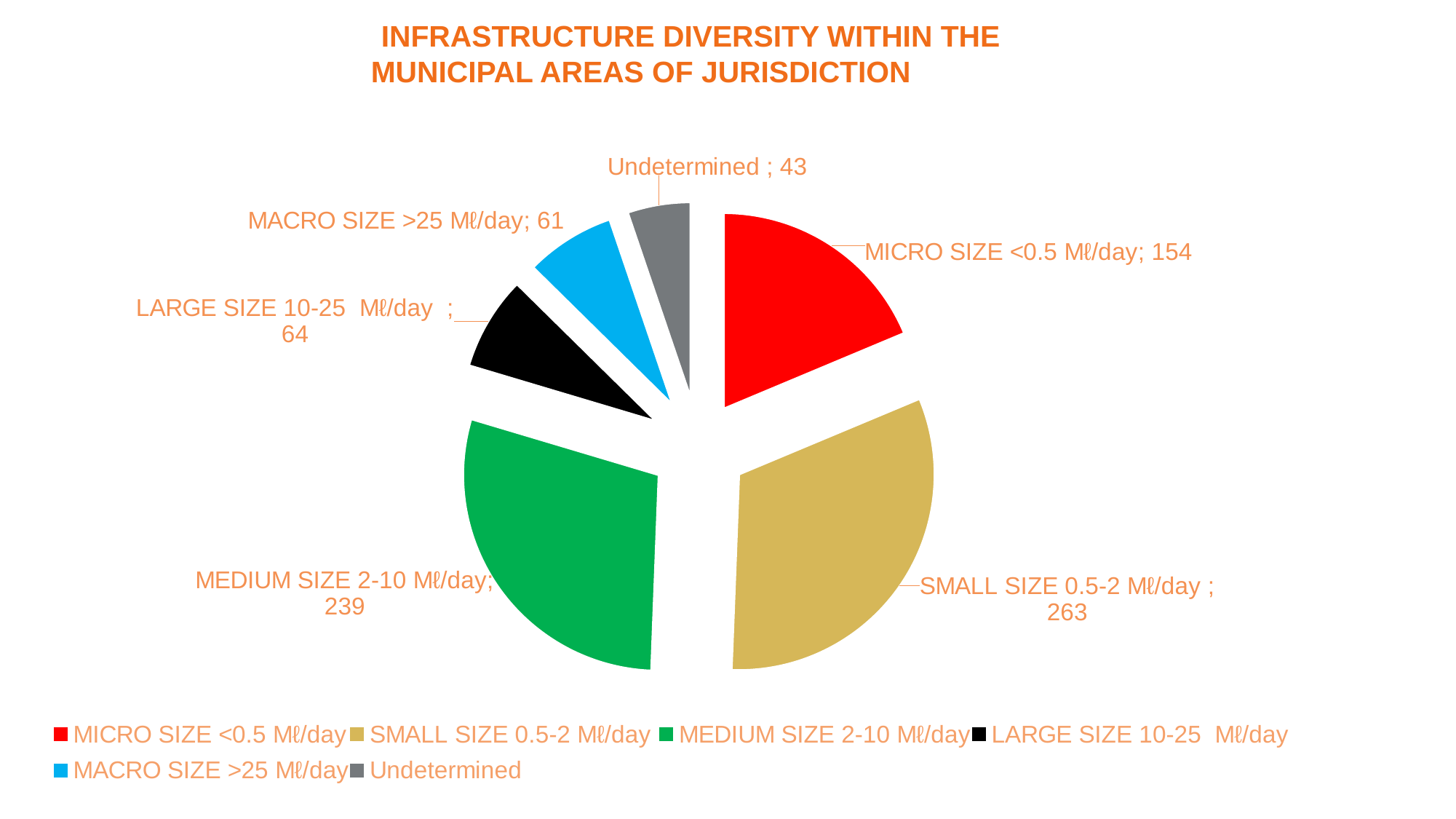
What is the value for MICRO SIZE <0.5 Mℓ/day? 154 What is the value for SMALL SIZE 0.5-2 Mℓ/day? 263 What is the total of all the slice values? 824 Which category has the smallest slice? Undetermined How many slices does the pie chart have? 6 What is the value for the Undetermined slice? 43 Which category has the largest slice? SMALL SIZE 0.5-2 Mℓ/day Which is larger, LARGE SIZE 10-25 Mℓ/day or MACRO SIZE >25 Mℓ/day? LARGE SIZE 10-25 Mℓ/day What type of chart is shown on the slide? Pie chart What is the title of the chart? INFRASTRUCTURE DIVERSITY WITHIN THE MUNICIPAL AREAS OF JURISDICTION What is the value for MACRO SIZE >25 Mℓ/day? 61 What is the difference between the values for SMALL SIZE 0.5-2 Mℓ/day and MEDIUM SIZE 2-10 Mℓ/day? 24